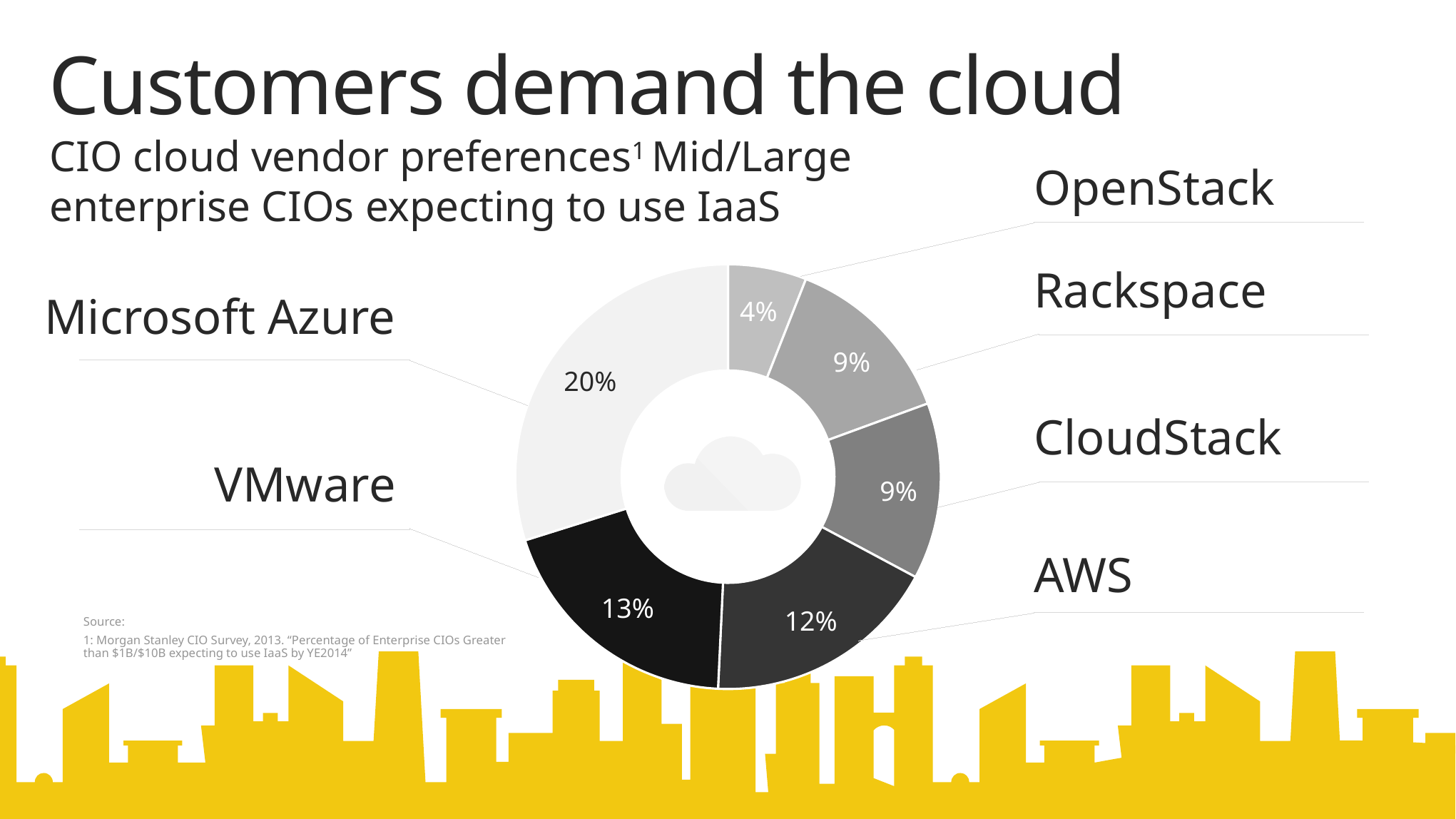
Which vendor has the smallest segment in the chart? OpenStack What percentage of CIOs prefer Microsoft Azure? 20% Which is larger, the value for VMware or the value for AWS? VMware What kind of chart is shown on the slide? Donut chart What is the value for OpenStack? 4% Which two vendors share the same percentage of 9%? Rackspace and CloudStack What percentage is shown for AWS? 12% How many vendors are shown in the chart? 6 Which vendor has the largest segment in the chart? Microsoft Azure What is the value shown for VMware? 13% What percentage is shown for Rackspace? 9% What is the difference between the Microsoft Azure and VMware percentages? 7%